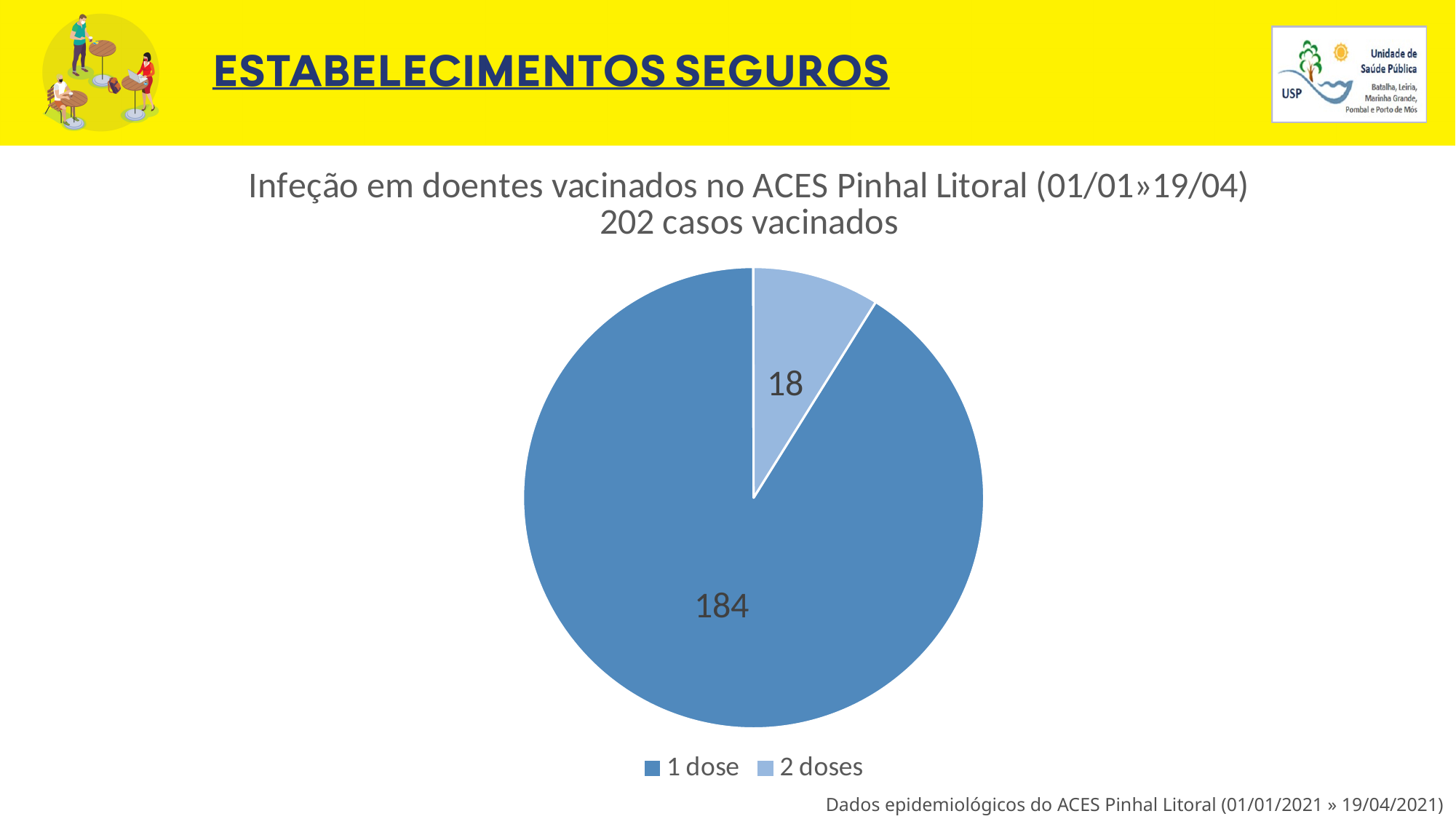
What is the difference between the values for "1 dose" and "2 doses"? 166 Which legend entry is shown in the lighter blue colour? 2 doses What is the value for "1 dose"? 184 How many slices does the pie chart have? 2 How many entries does the legend list? 2 Which category has the largest slice? 1 dose What is the title of the chart? Infeção em doentes vacinados no ACES Pinhal Litoral (01/01»19/04) 202 casos vacinados What type of chart is shown on the slide? pie chart What is the total of the two slices? 202 Which category has the smallest slice? 2 doses Which is larger, the value for "1 dose" or for "2 doses"? 1 dose What is the value for "2 doses"? 18